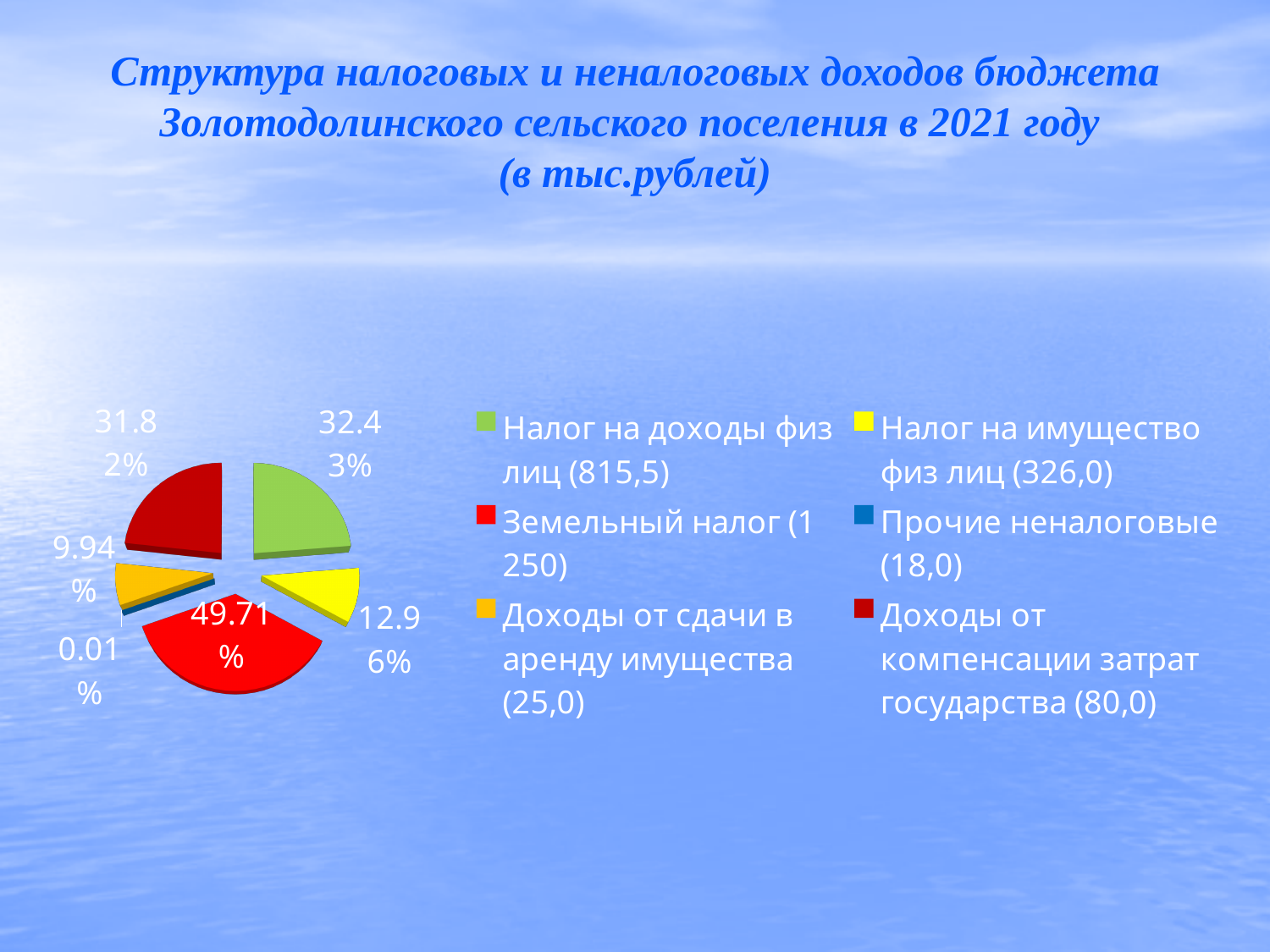
What kind of chart is shown on the slide? pie chart What value in thousand rubles does the legend give for Земельный налог? 1 250 What is the difference in percentage points between the Земельный налог slice (49.71%) and the Доходы от сдачи в аренду имущества slice (9.94%)? 39.77 What colour is the Земельный налог slice in the pie chart? red What percentage is shown for the Доходы от сдачи в аренду имущества slice? 9.94% What percentage is shown for the Земельный налог slice? 49.71% What value in thousand rubles does the legend give for Налог на имущество физ лиц? 326,0 Which slice is larger: Земельный налог or Налог на доходы физ лиц? Земельный налог Which category has the largest slice of the pie? Земельный налог What percentage is shown for the Прочие неналоговые slice? 0.01% How many categories does the legend of the pie chart list? 6 Which category has the smallest slice of the pie? Прочие неналоговые